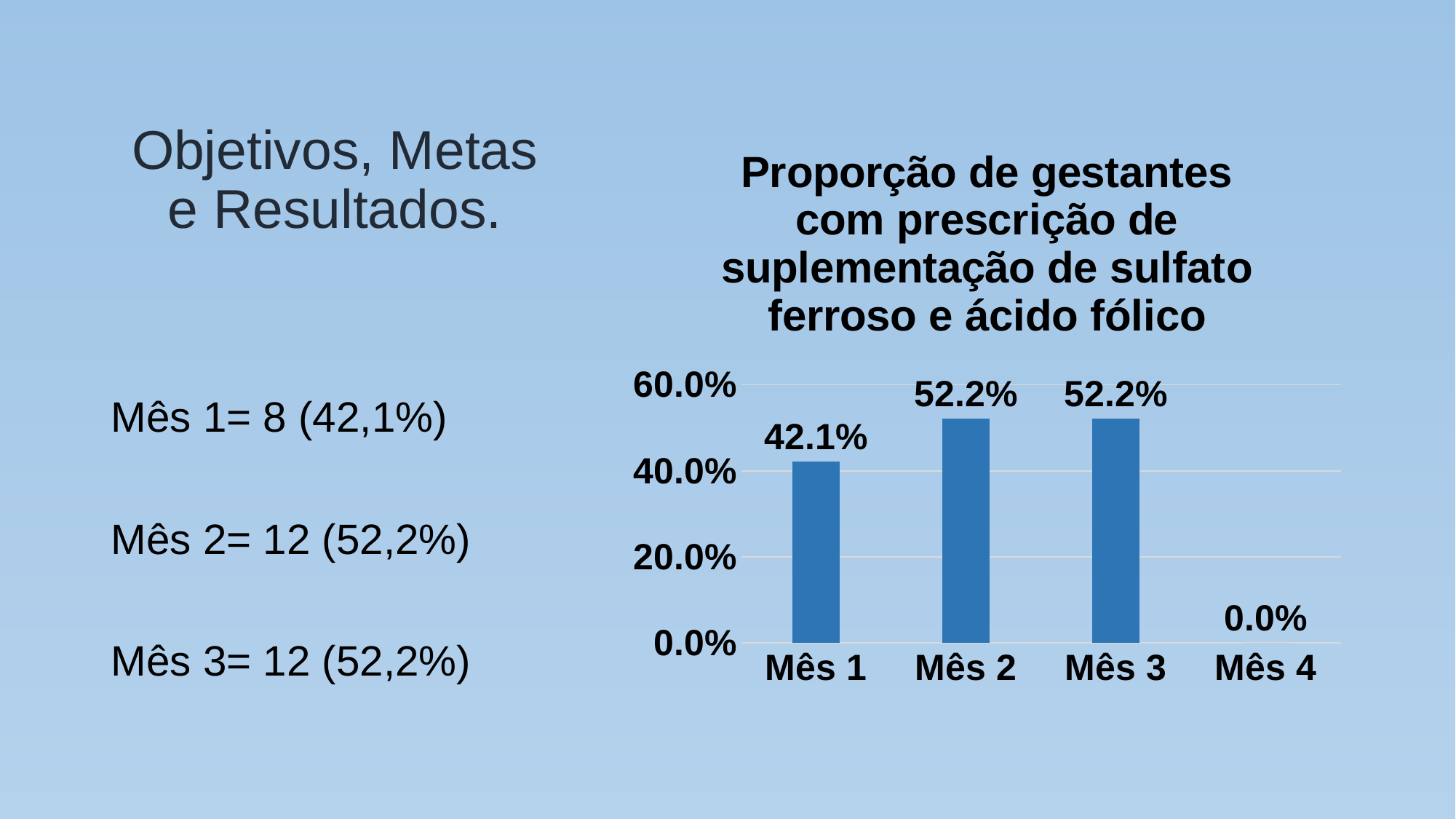
What is the value for Mês 1? 42.1% What is the value for Mês 2? 52.2% Which category has the lowest value? Mês 4 Do the values rise or fall from Mês 1 to Mês 2? rise Which is larger, the value for Mês 1 or the value for Mês 3? Mês 3 Is the value for Mês 2 greater or less than 60.0%? less What is the difference between the values for Mês 2 and Mês 1? 10.1% Is the value for Mês 1 greater or less than 40.0%? greater How many categories are shown on the x axis? 4 What kind of chart is shown? bar chart What is the title of the chart? Proporção de gestantes com prescrição de suplementação de sulfato ferroso e ácido fólico What is the value for Mês 4? 0.0%